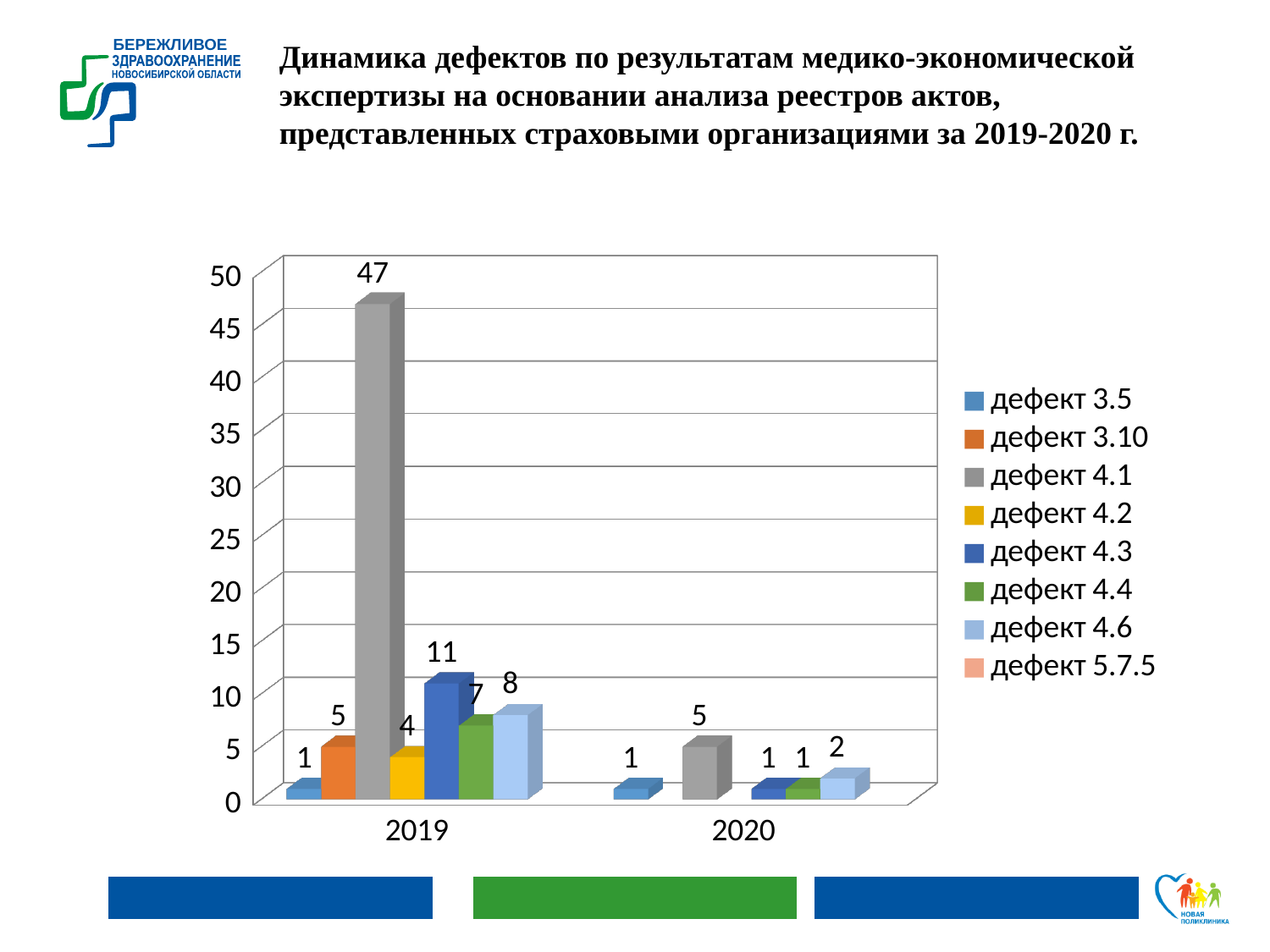
What is the value for дефект 3.10 in 2019? 5 Which is larger in 2019: the value for дефект 4.4 or дефект 4.6? дефект 4.6 What is the value for дефект 4.1 in 2019? 47 What is the value for дефект 4.1 in 2020? 5 How many series does the legend list? 8 How many year categories are shown on the x axis? 2 What is the difference between the value for дефект 4.1 in 2019 and in 2020? 42 What is the value for дефект 4.6 in 2020? 2 What kind of chart is shown on the slide? bar chart What is the value for дефект 4.3 in 2019? 11 Which series has the highest value in 2019? дефект 4.1 Is the value for дефект 4.1 in 2019 greater or less than 40? greater